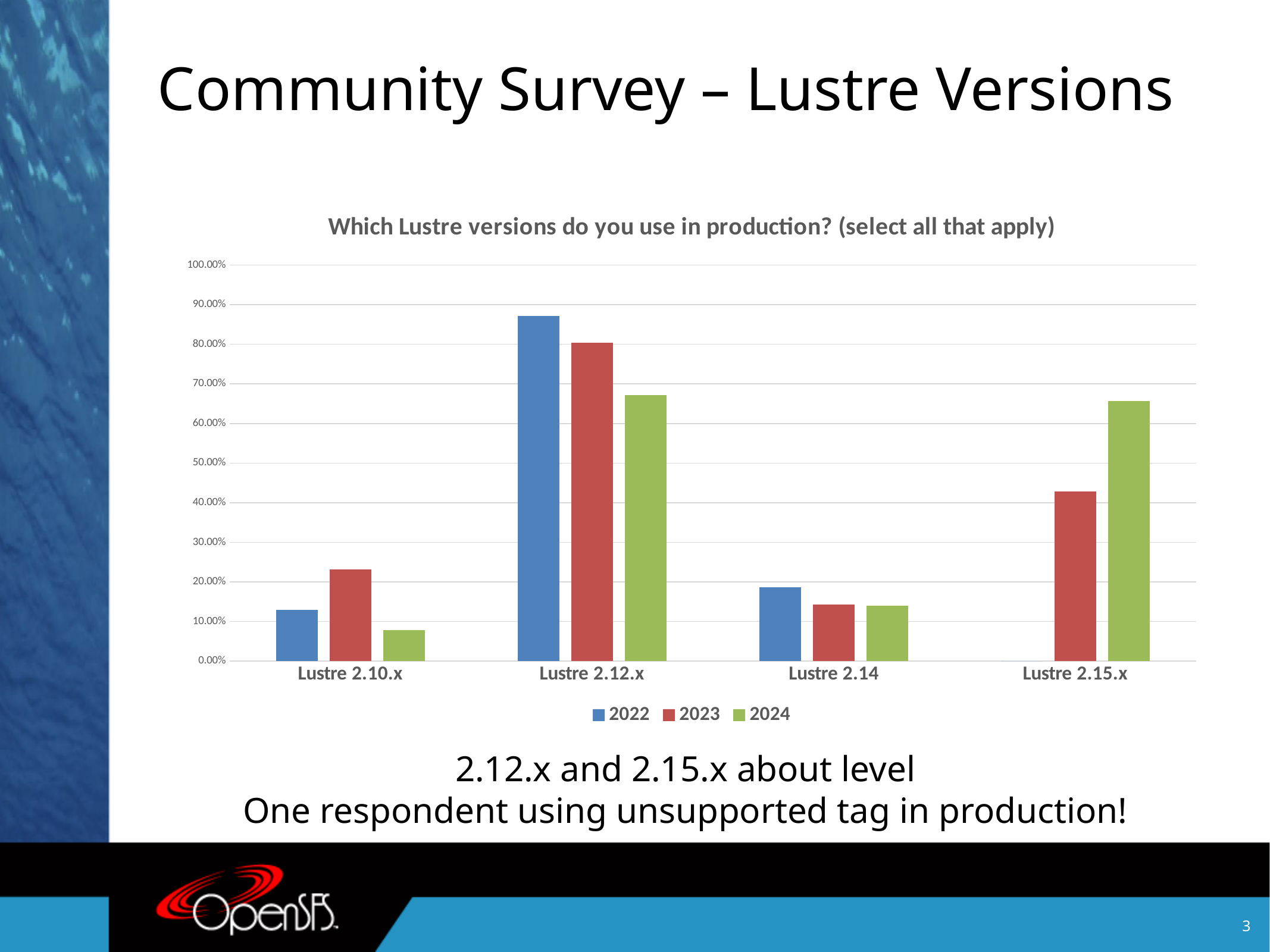
What kind of chart is shown on the slide? bar chart Does the value for Lustre 2.15.x rise or fall from 2023 to 2024? rise How many series does the legend list? 3 Which Lustre version has the lowest value for the 2024 series? Lustre 2.10.x Do the values for Lustre 2.12.x rise or fall from 2022 to 2024? fall For Lustre 2.10.x, which series is larger: 2022 or 2023? 2023 How many Lustre version categories are shown on the x axis? 4 Is the 2022 value for Lustre 2.12.x greater or less than 80.00%? greater Is the 2024 value for Lustre 2.10.x greater or less than 10.00%? less What are the entries listed in the chart legend? 2022, 2023, 2024 Which Lustre version has the highest value for the 2022 series? Lustre 2.12.x Is the 2023 value for Lustre 2.15.x greater or less than 50.00%? less